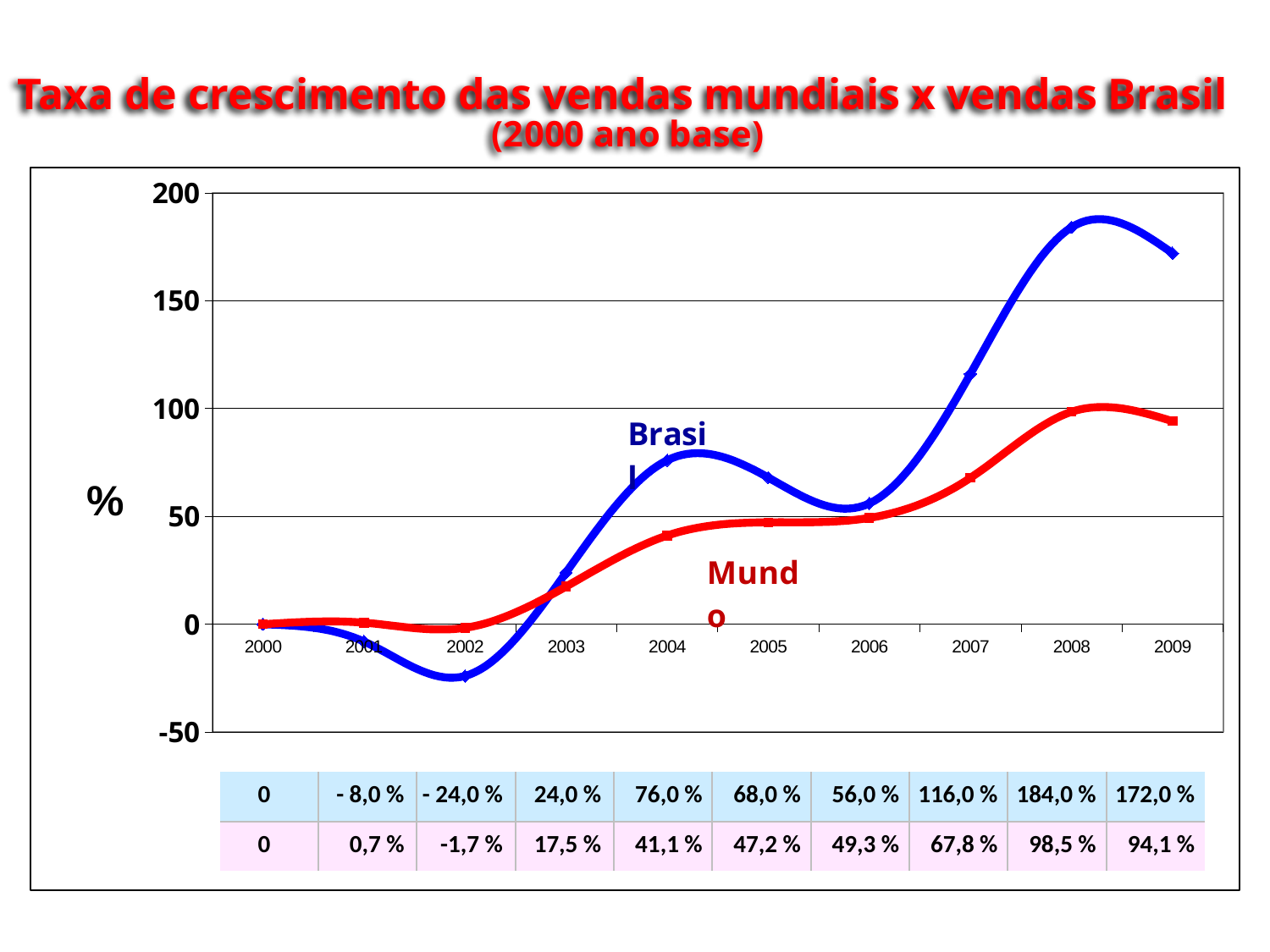
What is the value for Mundo in 2009? 94,1 % What is the value for Mundo in 2002? -1,7 % In which year does the Brasil series reach its lowest value? 2002 How many years are plotted on the x axis? 10 What is the value for Brasil in 2008? 184,0 % How many series are plotted in the chart? 2 What is the difference between the Mundo values for 2008 and 2007? 30,7 % In 2007, which series has the larger value, Brasil or Mundo? Brasil What kind of chart is shown on the slide? line chart Does the Mundo series rise or fall from 2003 to 2008? rise In which year does the Brasil series reach its highest value? 2008 By how much does the Brasil value in 2008 exceed the Brasil value in 2009? 12,0 %